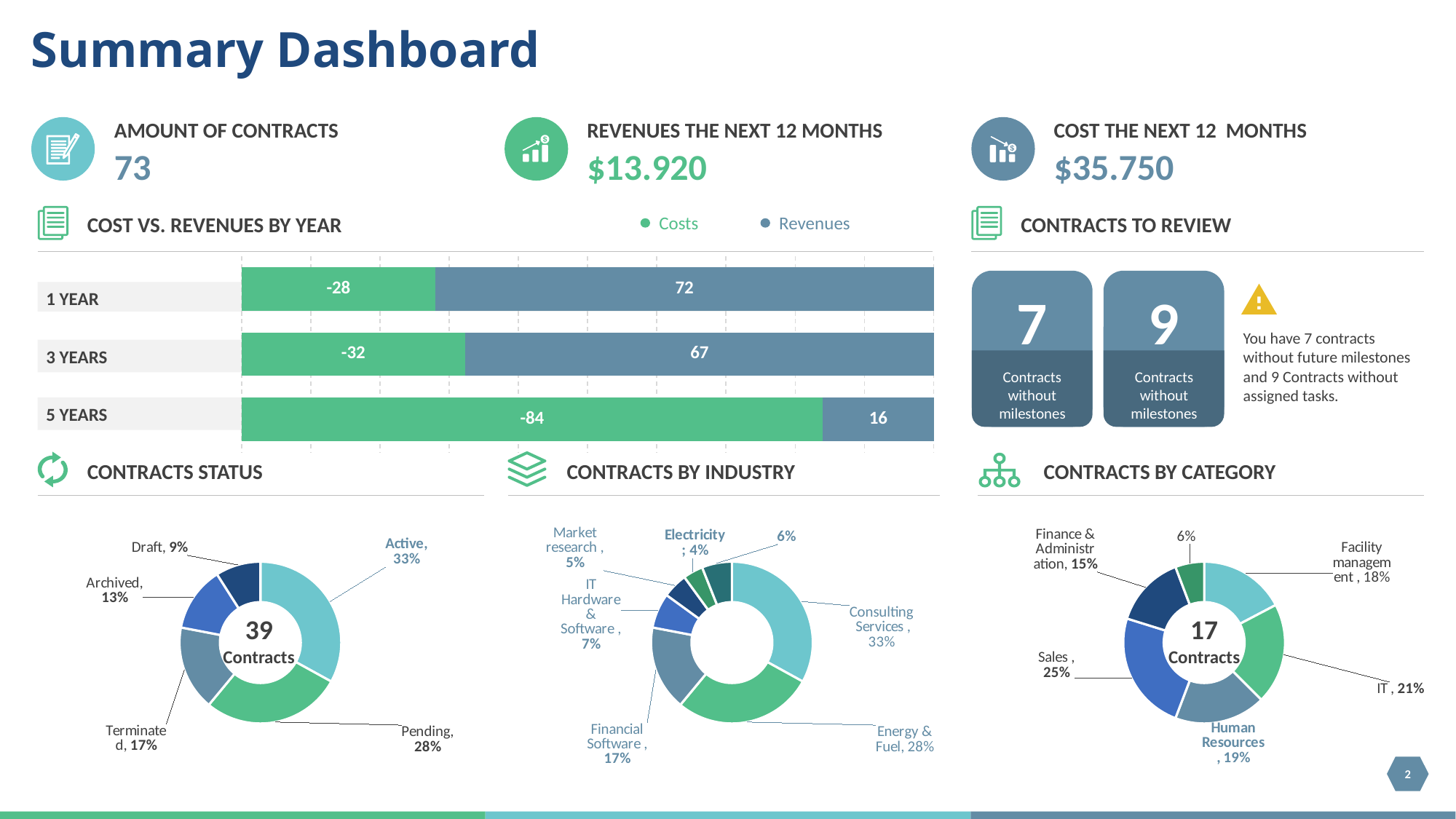
In the Contracts Status chart, what share do Active contracts have? 33% How many categories are shown in the Contracts Status chart? 5 How many series does the legend of the Cost vs. Revenues by Year chart list? 2 In the Cost vs. Revenues by Year chart, which year category has the highest Revenues value? 1 YEAR In the Cost vs. Revenues by Year chart, what is the difference between the Revenues for 1 YEAR and for 5 YEARS? 56 In the Contracts Status chart, which status has the smallest share? Draft In the Cost vs. Revenues by Year chart, do the Revenues values rise or fall from 1 YEAR to 5 YEARS? Fall What kind of chart is the Cost vs. Revenues by Year chart? Bar chart In the Cost vs. Revenues by Year chart, what is the Costs value for 5 YEARS? -84 In the Contracts by Industry chart, what share does Energy & Fuel have? 28% In the Cost vs. Revenues by Year chart, what is the Revenues value for 3 YEARS? 67 In the Contracts by Category chart, which category has the largest share? Sales